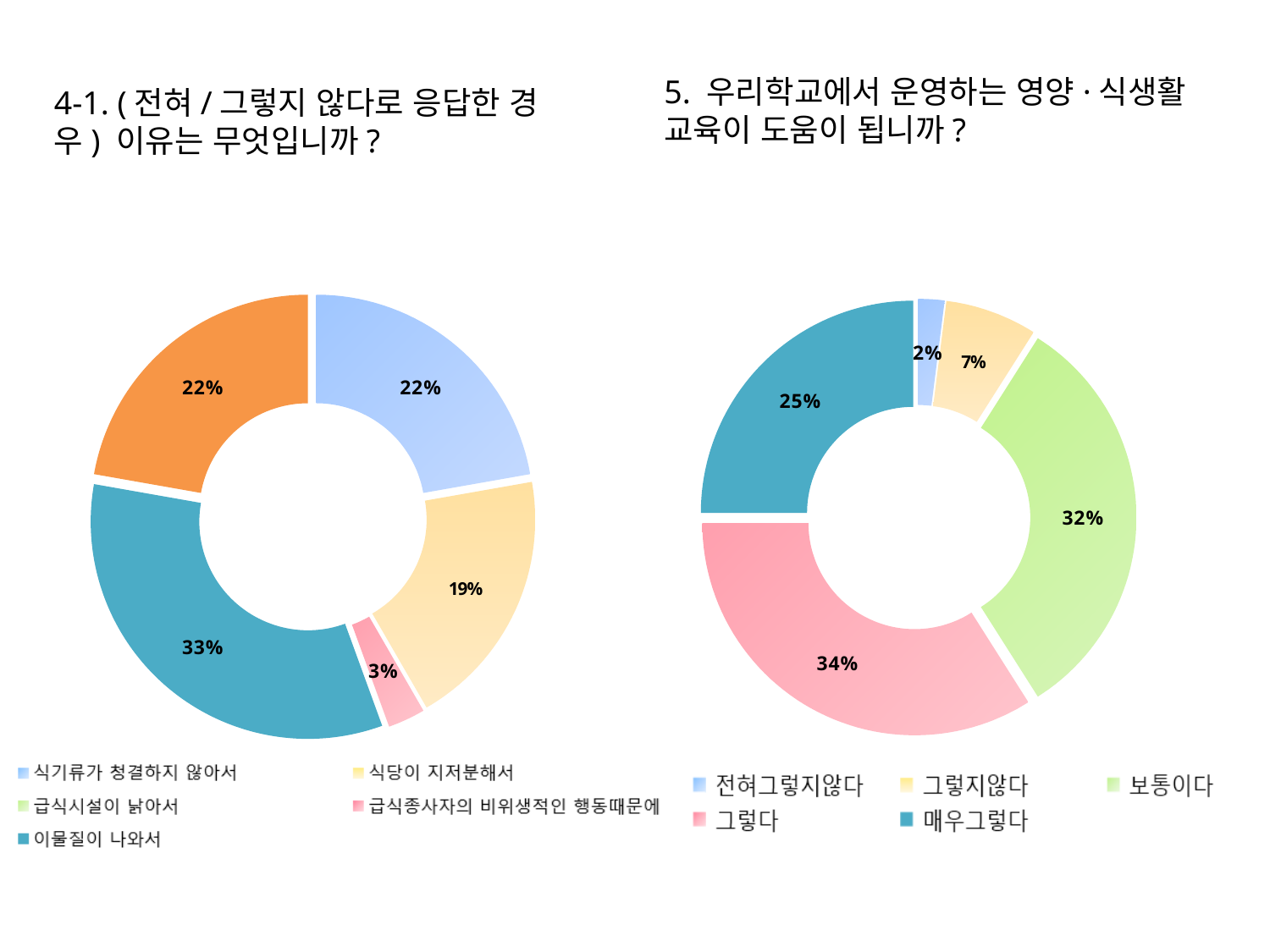
In the left chart (4-1), what percentage is shown for 식당이 지저분해서? 19% In the right chart (5), what percentage is shown for 전혀그렇지않다? 2% In the left chart (4-1), what percentage is shown for 급식종사자의 비위생적인 행동때문에? 3% In the left chart (4-1), what is the difference between the shares for 이물질이 나와서 and 식당이 지저분해서? 14% In the right chart (5), which category has the smallest share? 전혀그렇지않다 In the left chart (4-1), what percentage is shown for 이물질이 나와서? 33% In the right chart (5), which is larger, the share for 보통이다 or the share for 매우그렇다? 보통이다 In the right chart (5), what percentage is shown for 매우그렇다? 25% In the left chart (4-1), which category has the largest share? 이물질이 나와서 How many categories does the legend of the right chart (5) list? 5 In the right chart (5), what percentage is shown for 그렇다? 34%